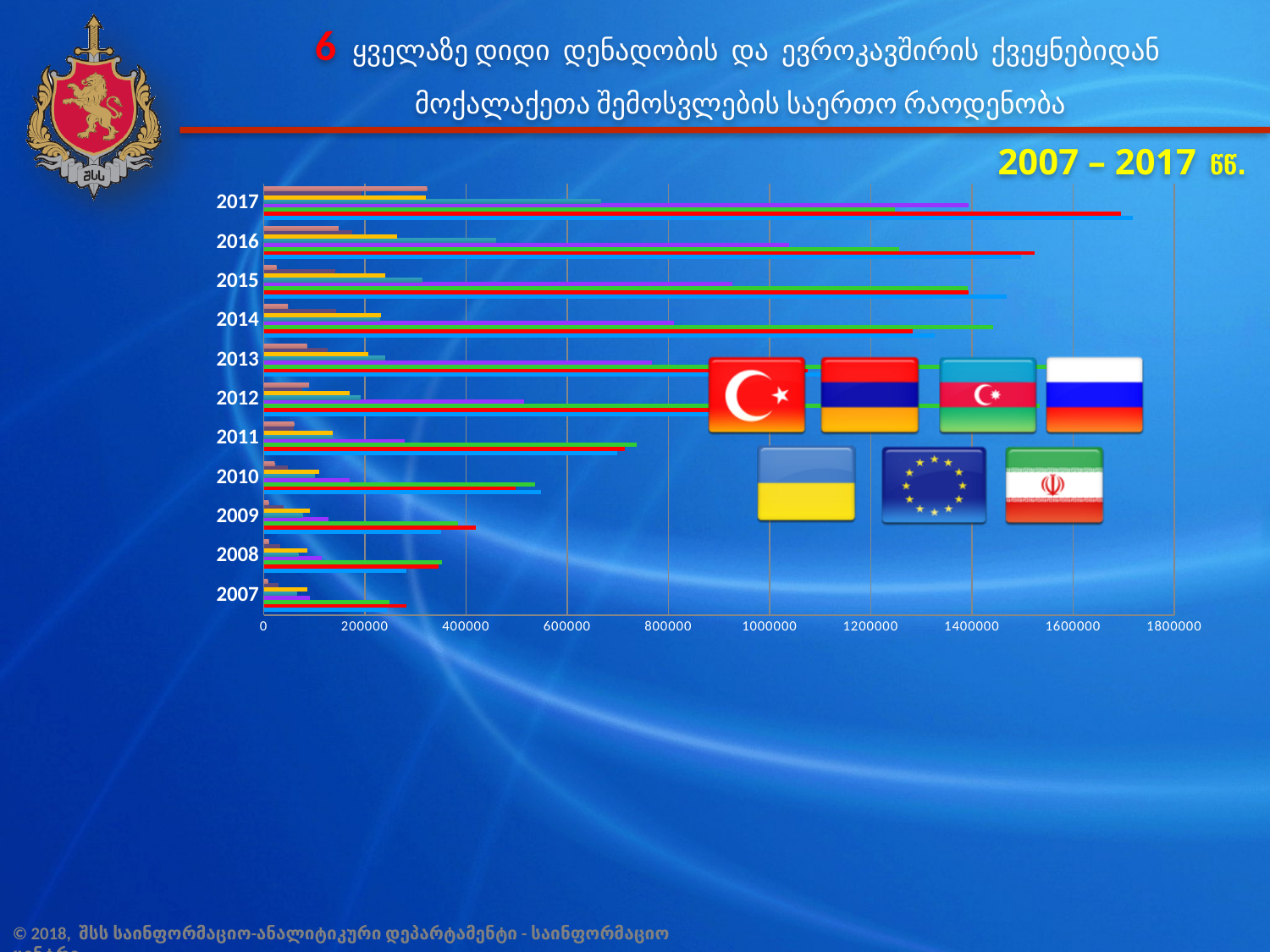
Is the longest bar for 2017 greater or less than 1600000? greater Which year has the shortest longest-bar in the chart? 2007 What is the highest value shown on the horizontal axis of the chart? 1800000 Is the longest bar for 2017 larger than the longest bar for 2010? yes Is the longest bar for 2007 greater or less than 400000? less Is the longest bar for 2011 greater or less than 800000? less What kind of chart is shown on the slide? bar chart How many years are listed on the vertical axis of the chart? 11 Which year has the longest bar in the chart? 2017 Do the longest bars generally rise or fall from 2007 to 2017? rise